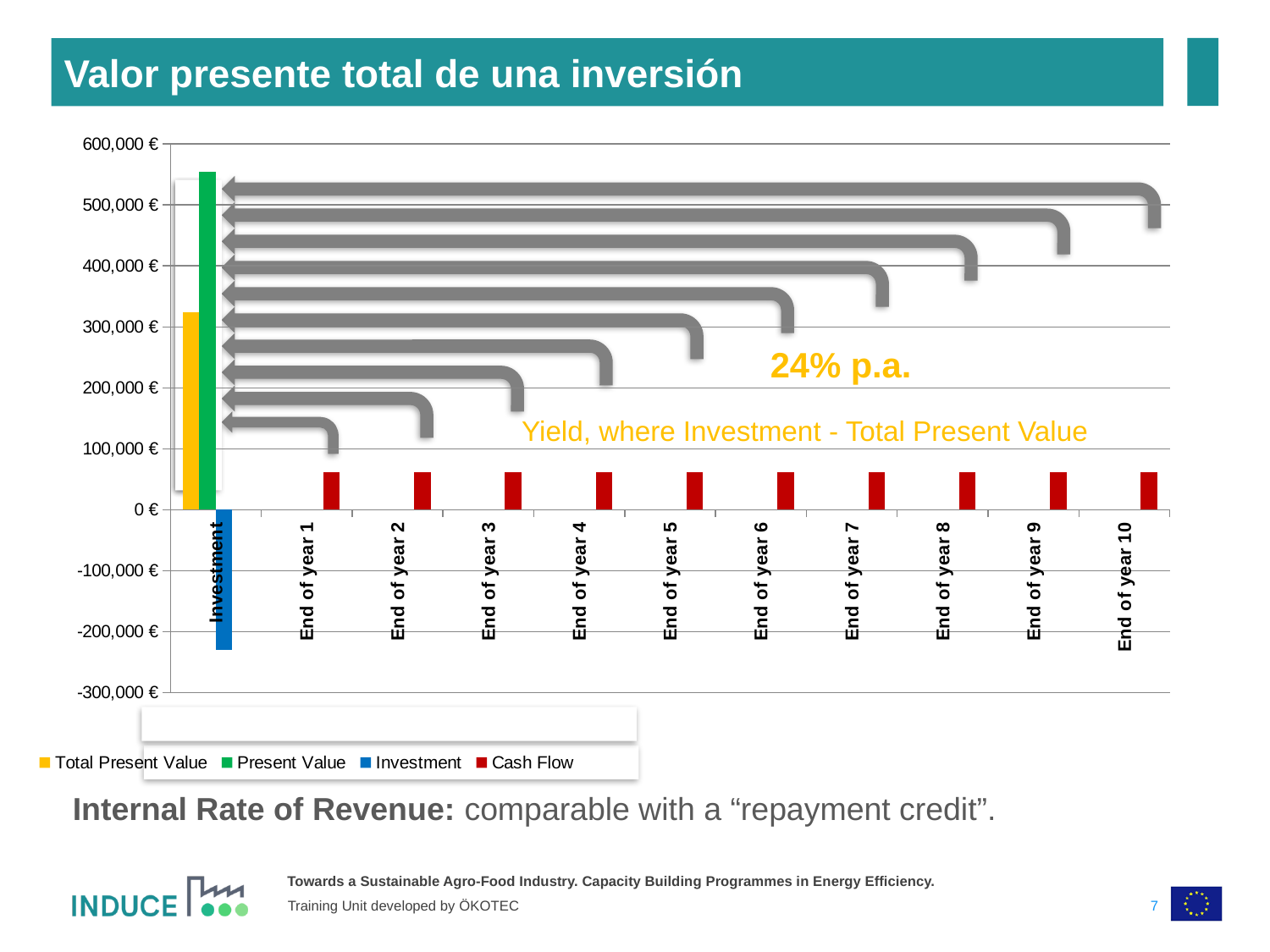
What kind of chart is shown on the slide? bar chart How many series does the chart legend list? 4 What is the title of the slide containing the chart? Valor presente total de una inversión Which series has the lowest (most negative) value in the chart? Investment Is the value of the Total Present Value bar greater or less than 400,000 €? less Is the value of the Present Value bar greater or less than 500,000 €? greater What colour represents the Cash Flow series in the legend? red Is the Cash Flow value at End of year 5 greater or less than 100,000 €? less Do the Cash Flow bars rise, fall or stay constant from End of year 1 to End of year 10? stay constant Which is larger, the Present Value bar or the Total Present Value bar? Present Value How many categories are shown along the x axis of the chart? 11